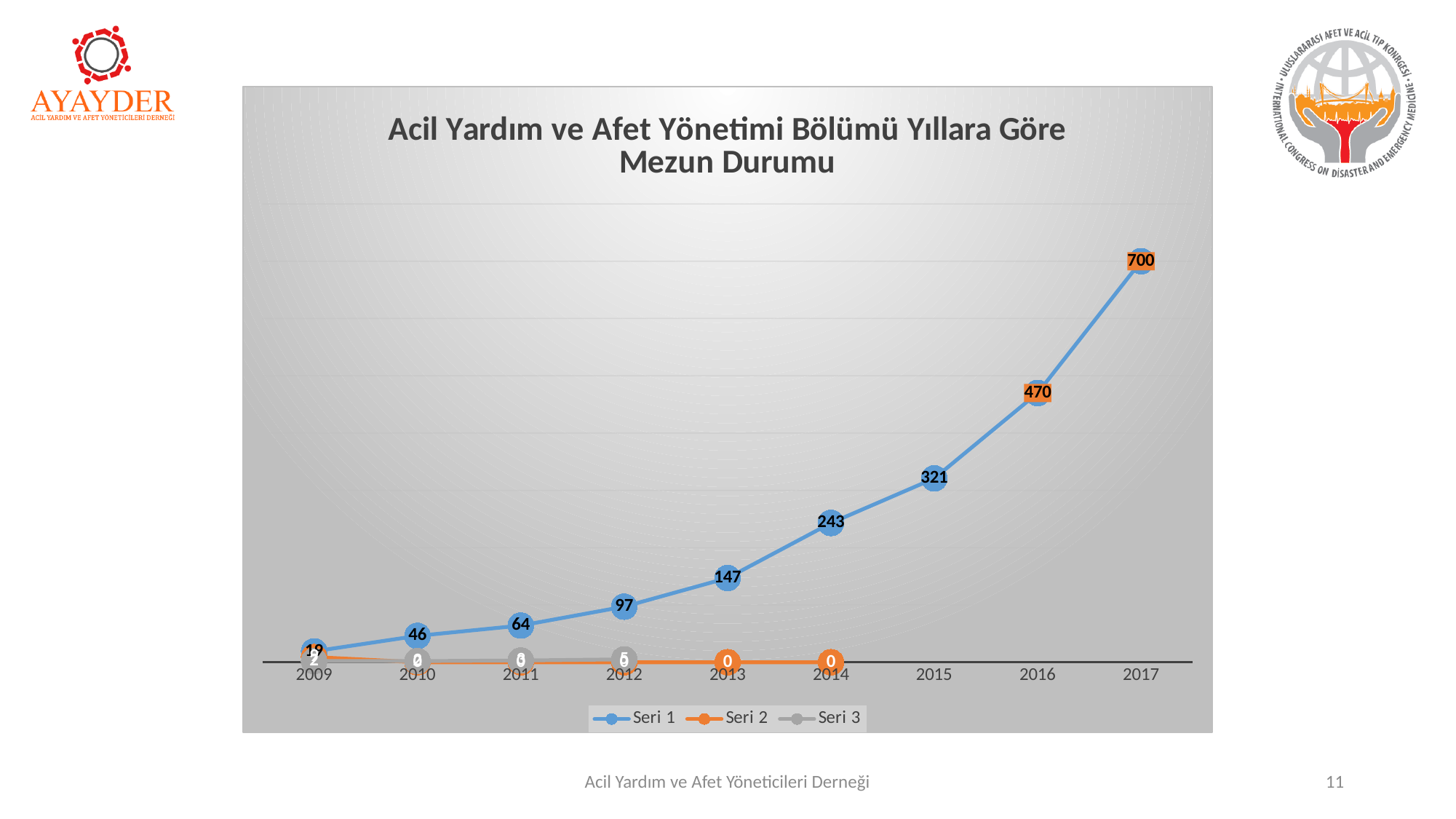
In which year does Seri 1 have its lowest value? 2009 How many years are shown on the x axis? 9 What is the value of Seri 1 in 2010? 46 Which is larger for Seri 1: the value in 2014 or the value in 2015? 2015 What is the value of Seri 1 in 2013? 147 Does Seri 1 rise or fall from 2009 to 2017? rise In which year does Seri 1 reach its highest value? 2017 What is the value of Seri 1 in 2017? 700 What is the title of the chart? Acil Yardım ve Afet Yönetimi Bölümü Yıllara Göre Mezun Durumu What is the difference between the Seri 1 values for 2017 and 2016? 230 How many series does the legend list? 3 What type of chart is shown on the slide? line chart